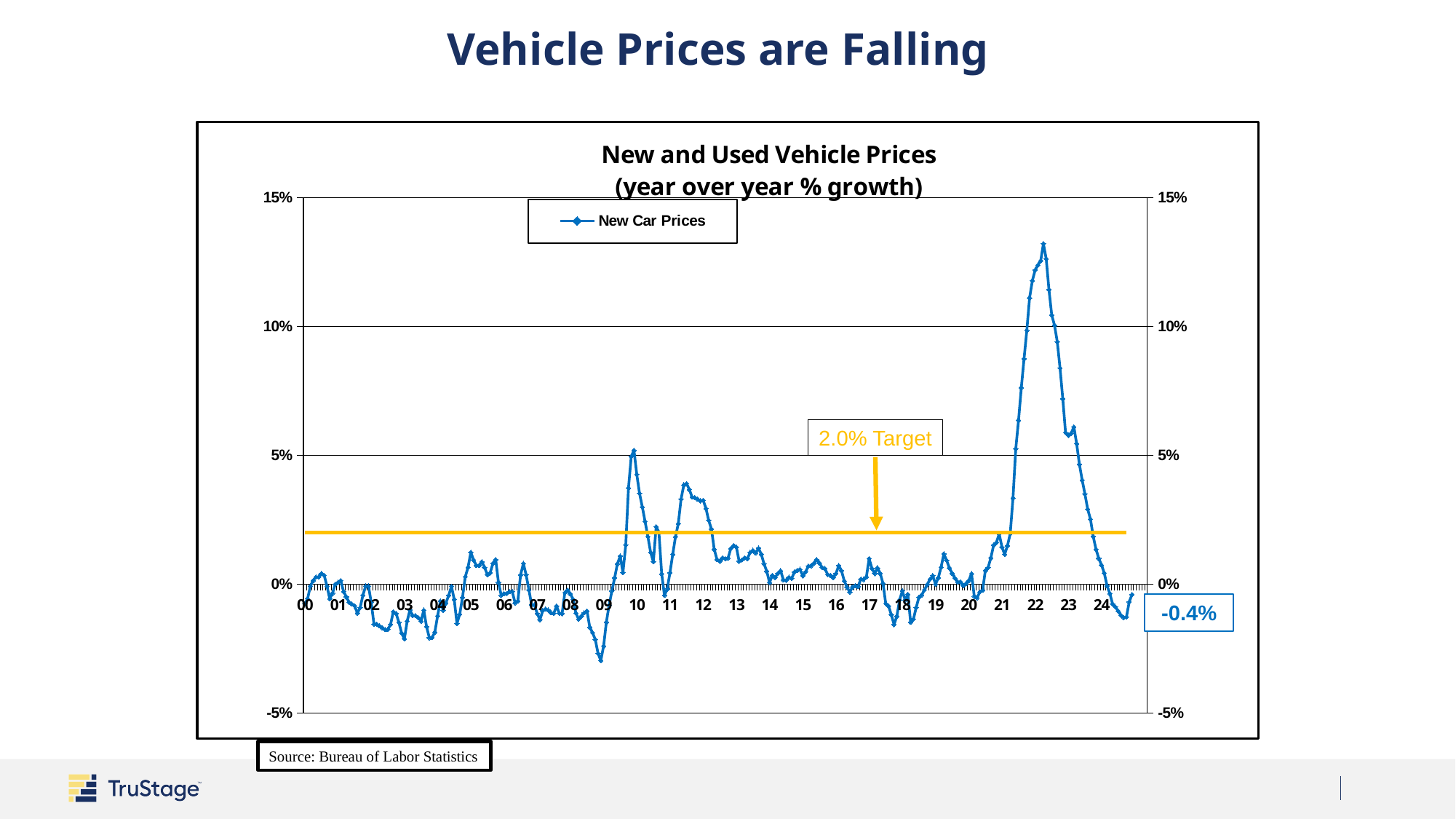
Is the value of New Car Prices at the peak around 22 larger or smaller than the value at the peak around 10? larger What is the name of the series shown in the legend? New Car Prices Is the peak value of New Car Prices around 22 greater or less than 15%? less Is the lowest value of New Car Prices around 09 greater or less than 0%? less Is the peak value of New Car Prices around 22 greater or less than 10%? greater What target value is marked by the horizontal line on the chart? 2.0% What kind of chart is shown on the slide? line chart What is the most recent value of New Car Prices labelled at the end of the line? -0.4% Do New Car Prices rise or fall between 22 and 24? fall How many year labels are shown on the x axis? 25 In which year on the x axis does New Car Prices reach its highest value? 22 How many series does the legend list? 1